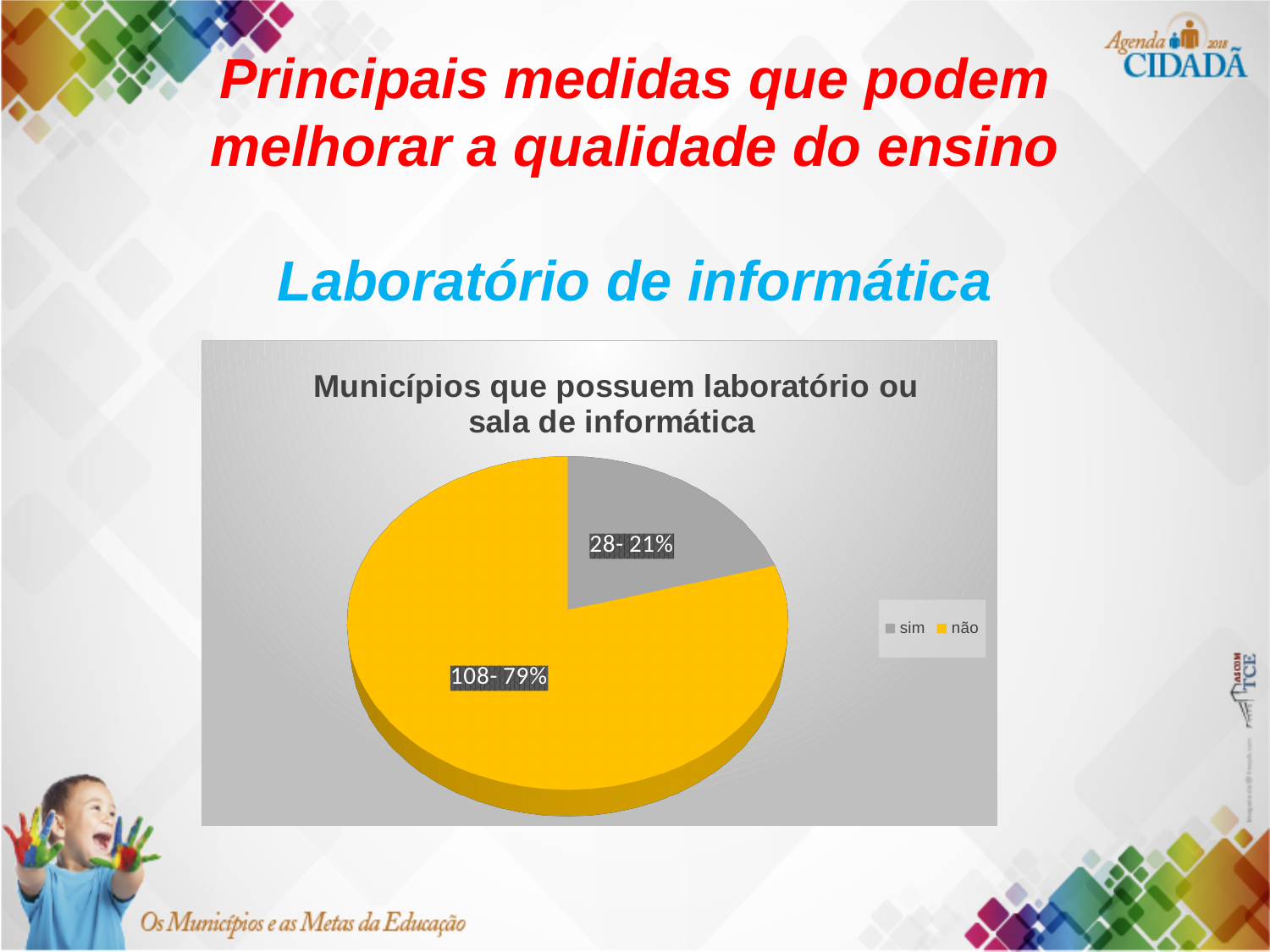
Which category has the largest slice? não What kind of chart is shown on the slide? pie chart What is the title of the chart? Municípios que possuem laboratório ou sala de informática How many slices does the pie chart have? 2 Which category has the smallest slice? sim How many entries does the legend list? 2 What share of the pie does the 'não' slice represent? 79% What is the data label shown on the 'sim' slice? 28- 21% What share of the pie does the 'sim' slice represent? 21% What is the data label shown on the 'não' slice? 108- 79% What is the difference in count between the 'não' and 'sim' slices? 80 Which colour represents 'não' in the chart? yellow